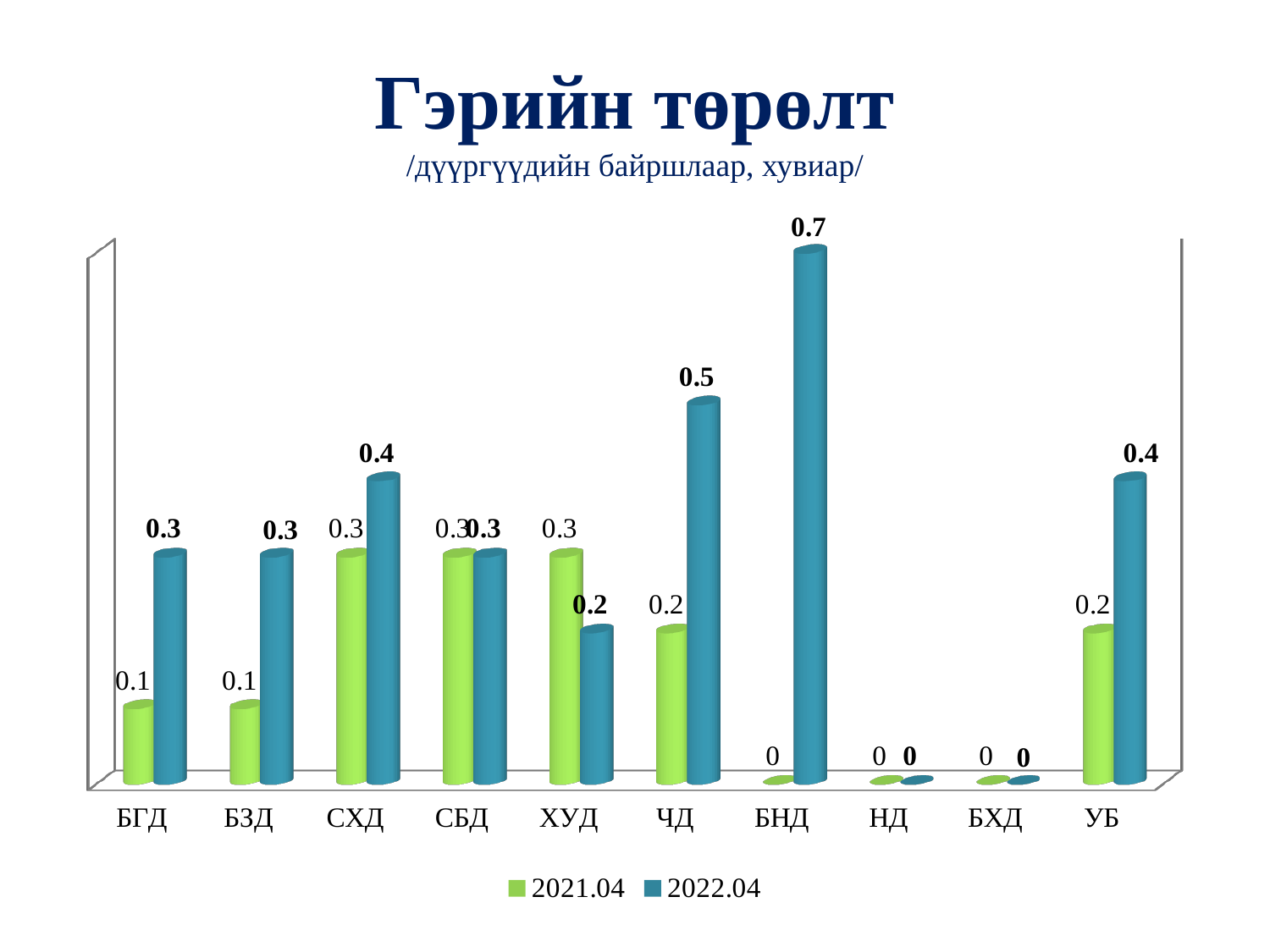
What is the difference between the 2022.04 and 2021.04 values for ЧД? 0.3 What kind of chart is shown on the slide? Bar chart What is the value for ЧД in the 2021.04 series? 0.2 What is the value for УБ in the 2022.04 series? 0.4 What is the value for БНД in the 2022.04 series? 0.7 What is the title of the chart on the slide? Гэрийн төрөлт Which category has the highest value in the 2022.04 series? БНД How many categories are shown on the x axis? 10 What is the difference between the 2022.04 and 2021.04 values for БГД? 0.2 How many series does the legend list? 2 What is the value for ХУД in the 2021.04 series? 0.3 Which is larger for ХУД: the 2021.04 value or the 2022.04 value? 2021.04